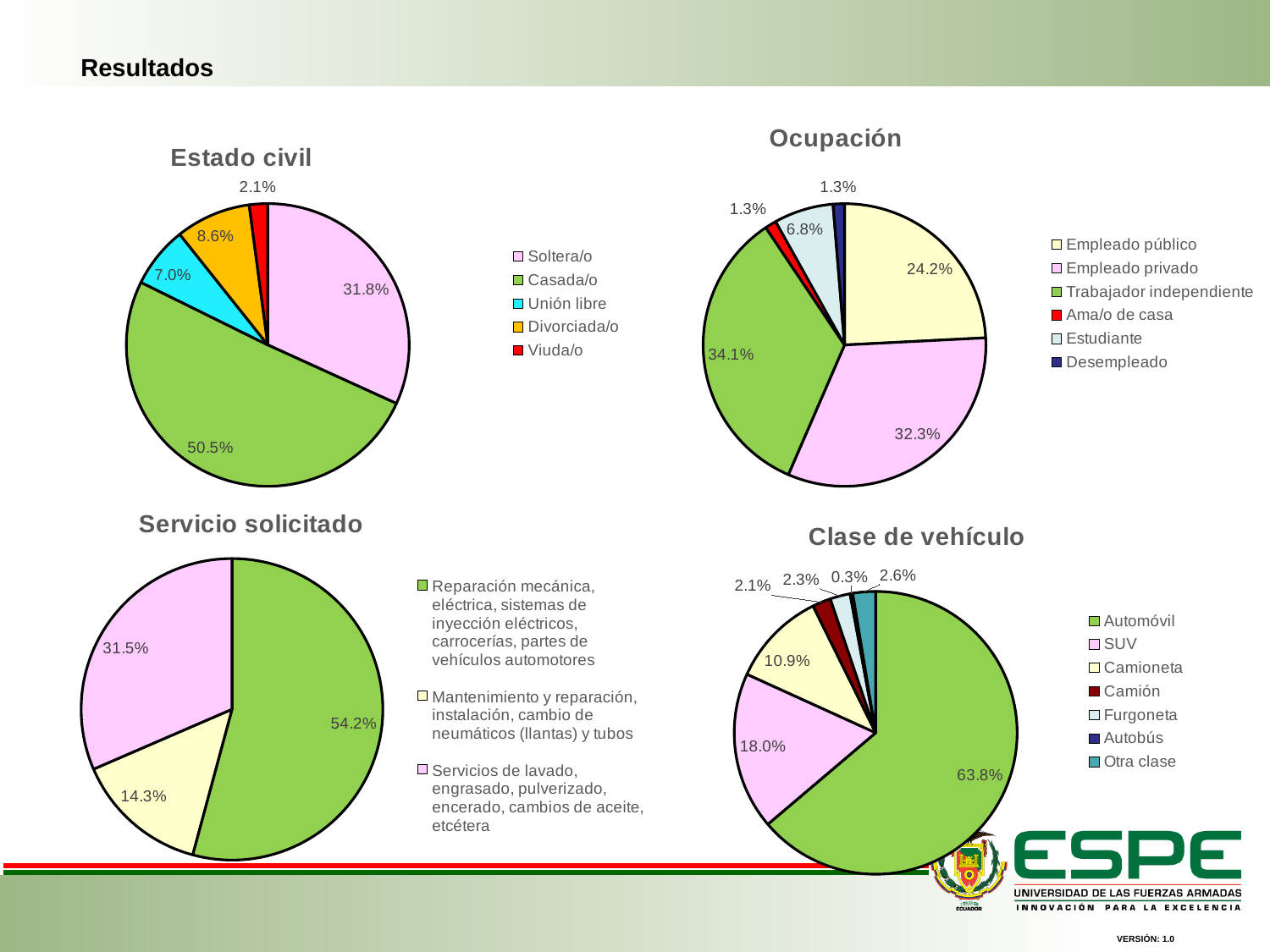
In the Clase de vehículo chart, what percentage is SUV? 18.0% In the Ocupación chart, which is larger, Empleado público or Empleado privado? Empleado privado In the Clase de vehículo chart, which category has the smallest share? Autobús In the Estado civil chart, what percentage is Casada/o? 50.5% In the Servicio solicitado chart, what percentage is Mantenimiento y reparación, instalación, cambio de neumáticos (llantas) y tubos? 14.3% In the Servicio solicitado chart, which category has the largest share? Reparación mecánica, eléctrica, sistemas de inyección eléctricos, carrocerías, partes de vehículos automotores In the Ocupación chart, how many categories does the legend list? 6 In the Estado civil chart, what is the difference between Soltera/o and Unión libre? 24.8% In the Estado civil chart, which category has the smallest share? Viuda/o In the Ocupación chart, what percentage is Trabajador independiente? 34.1% How many charts are shown on the slide? 4 What type of chart is used for Clase de vehículo? Pie chart